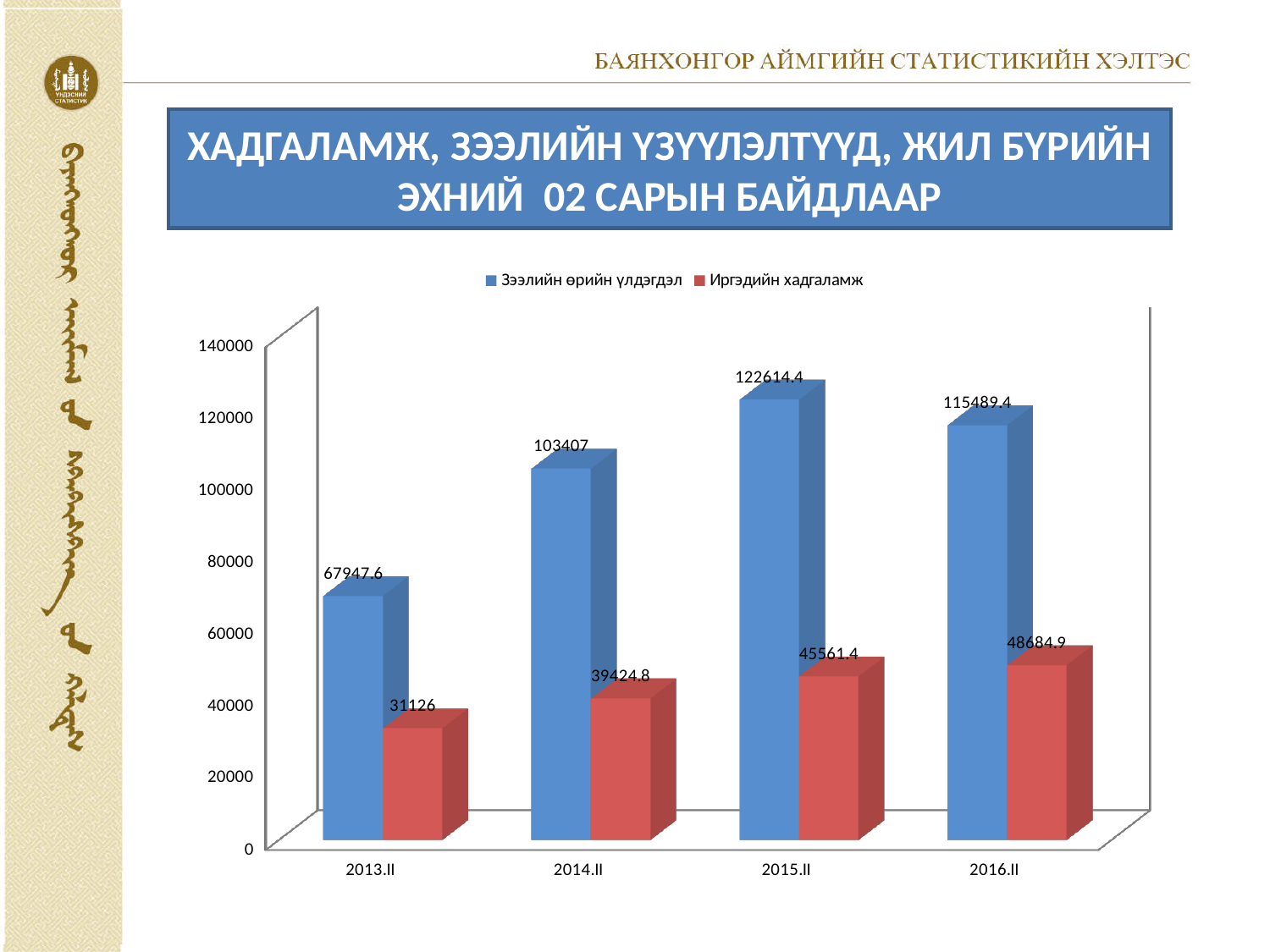
In which period is Зээлийн өрийн үлдэгдэл highest? 2015.II In which period is Иргэдийн хадгаламж lowest? 2013.II How many periods are shown on the x axis? 4 What is the value of Зээлийн өрийн үлдэгдэл for 2014.II? 103407 What is the value of Зээлийн өрийн үлдэгдэл for 2015.II? 122614.4 Which is larger in 2014.II: Зээлийн өрийн үлдэгдэл or Иргэдийн хадгаламж? Зээлийн өрийн үлдэгдэл What is the difference between Иргэдийн хадгаламж in 2016.II and 2015.II? 3123.5 What is the value of Иргэдийн хадгаламж for 2013.II? 31126 What is the value of Иргэдийн хадгаламж for 2016.II? 48684.9 What kind of chart is shown on the slide? Bar chart What is the difference between Зээлийн өрийн үлдэгдэл in 2015.II and 2016.II? 7125 How many series does the legend list? 2